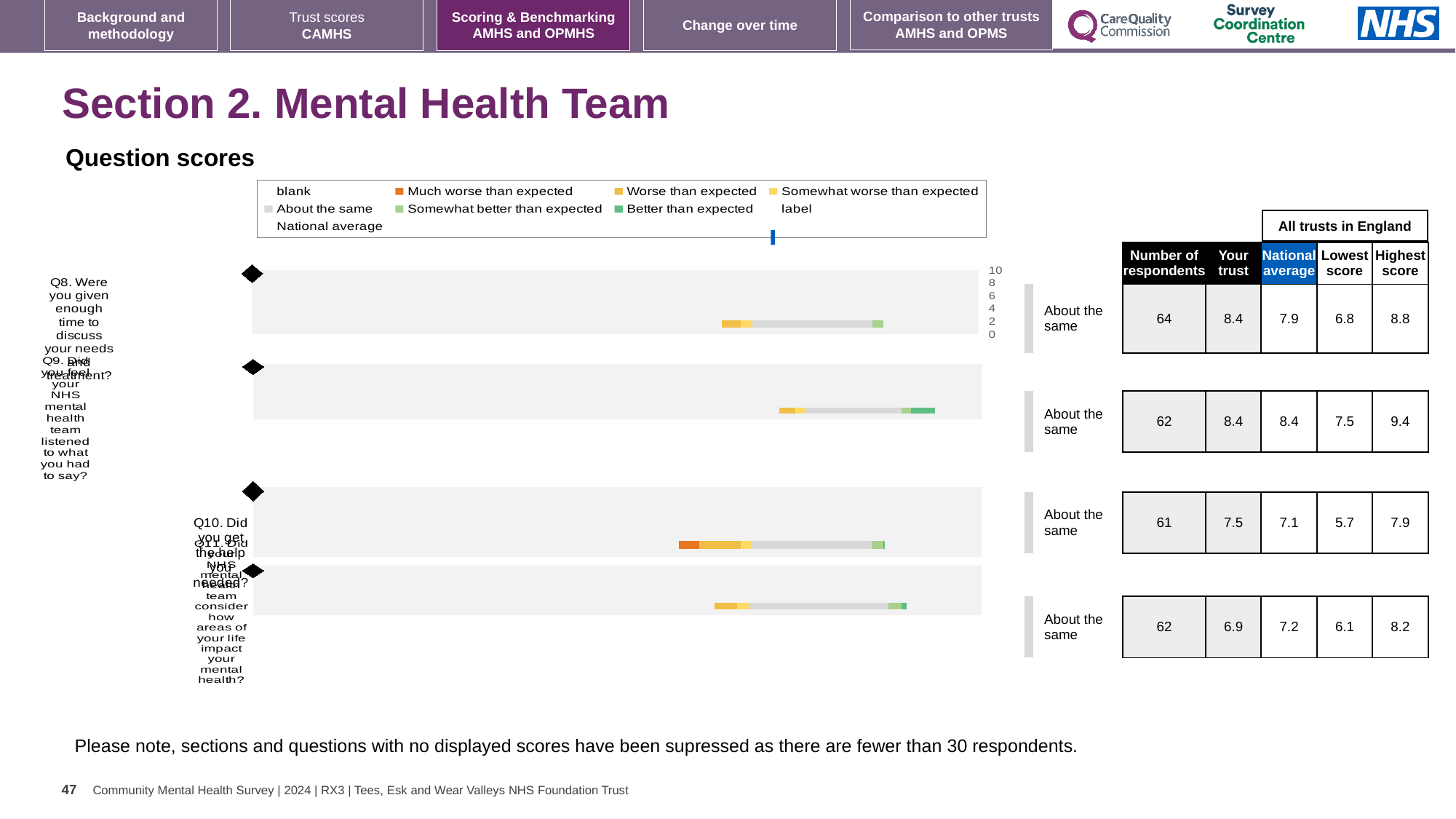
For Q11, which is larger: the 'Your trust' score or the national average? National average Which question has the highest 'Highest score' value in the table? Q9 What benchmark label is shown for Q10 next to the chart? About the same What kind of chart is shown under 'Question scores'? bar chart What is the highest tick value shown on the chart's score axis? 10 Which question has the lowest 'Your trust' score in the table? Q11 What is the difference between the 'Your trust' score and the national average for Q8? 0.5 How many respondents are listed for Q9? 62 Which legend entry is shown in orange in the Question scores chart? Much worse than expected How many questions (bars) are plotted in the Question scores chart? 4 What is the national average for Q10 in the table next to the chart? 7.1 What is the 'Your trust' score for Q8 in the table next to the chart? 8.4